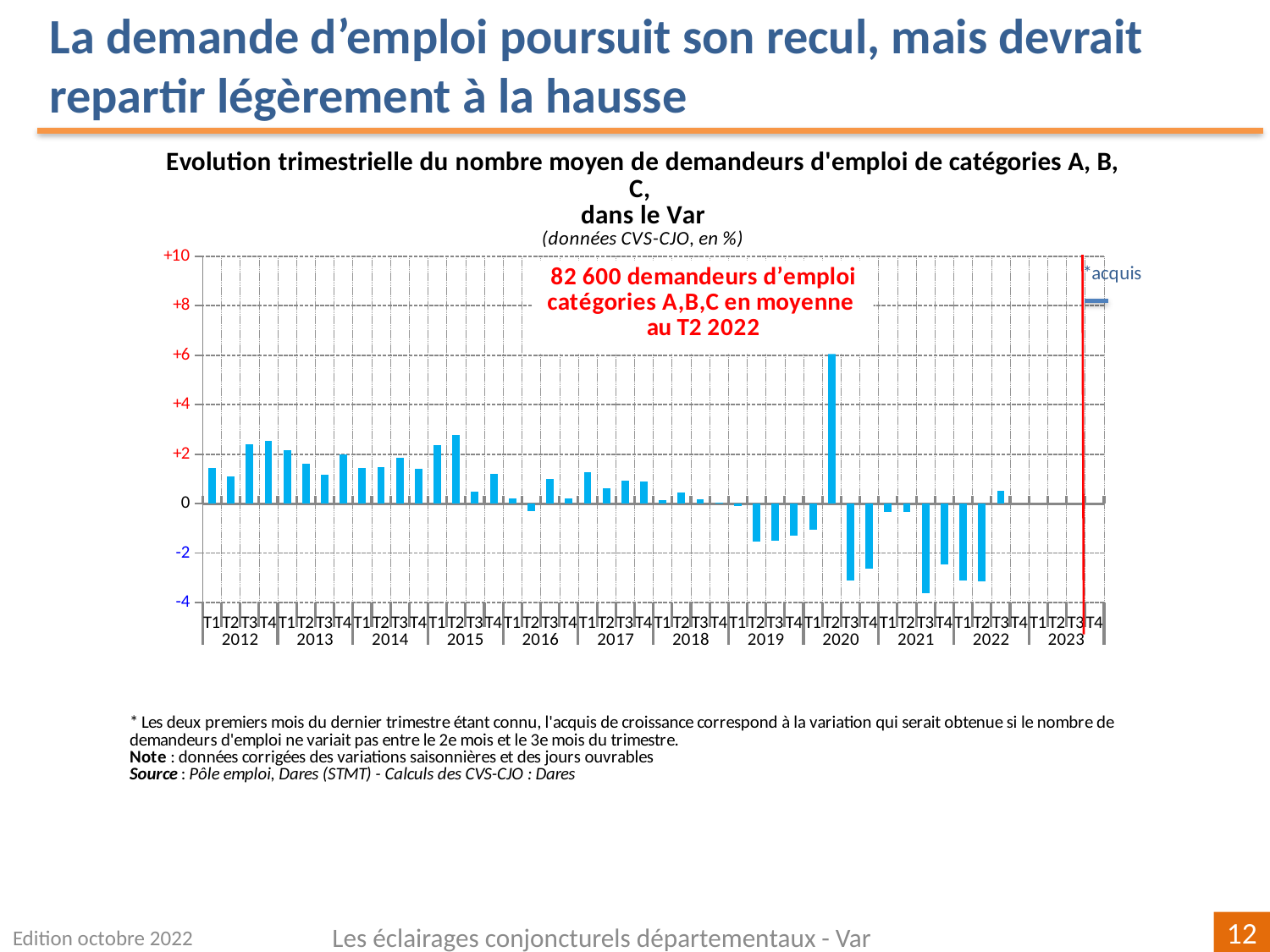
Is the value for T1 2021 greater or less than -2? greater According to the annotation on the chart, how many demandeurs d'emploi catégories A,B,C were there on average in T2 2022? 82 600 Is the value for T2 2020 greater or less than +4? greater Is the value for T1 2020 greater or less than 0? less What kind of chart is shown on the slide? Bar chart In what unit are the chart's data expressed, according to the subtitle? en % Which is larger, the value for T1 2012 or the value for T1 2018? T1 2012 Which quarter has the highest value in the chart? T2 2020 How many years are labelled along the x axis? 12 Are the quarterly values in 2019 positive or negative? negative Which is larger, the value for T2 2020 or the value for T2 2015? T2 2020